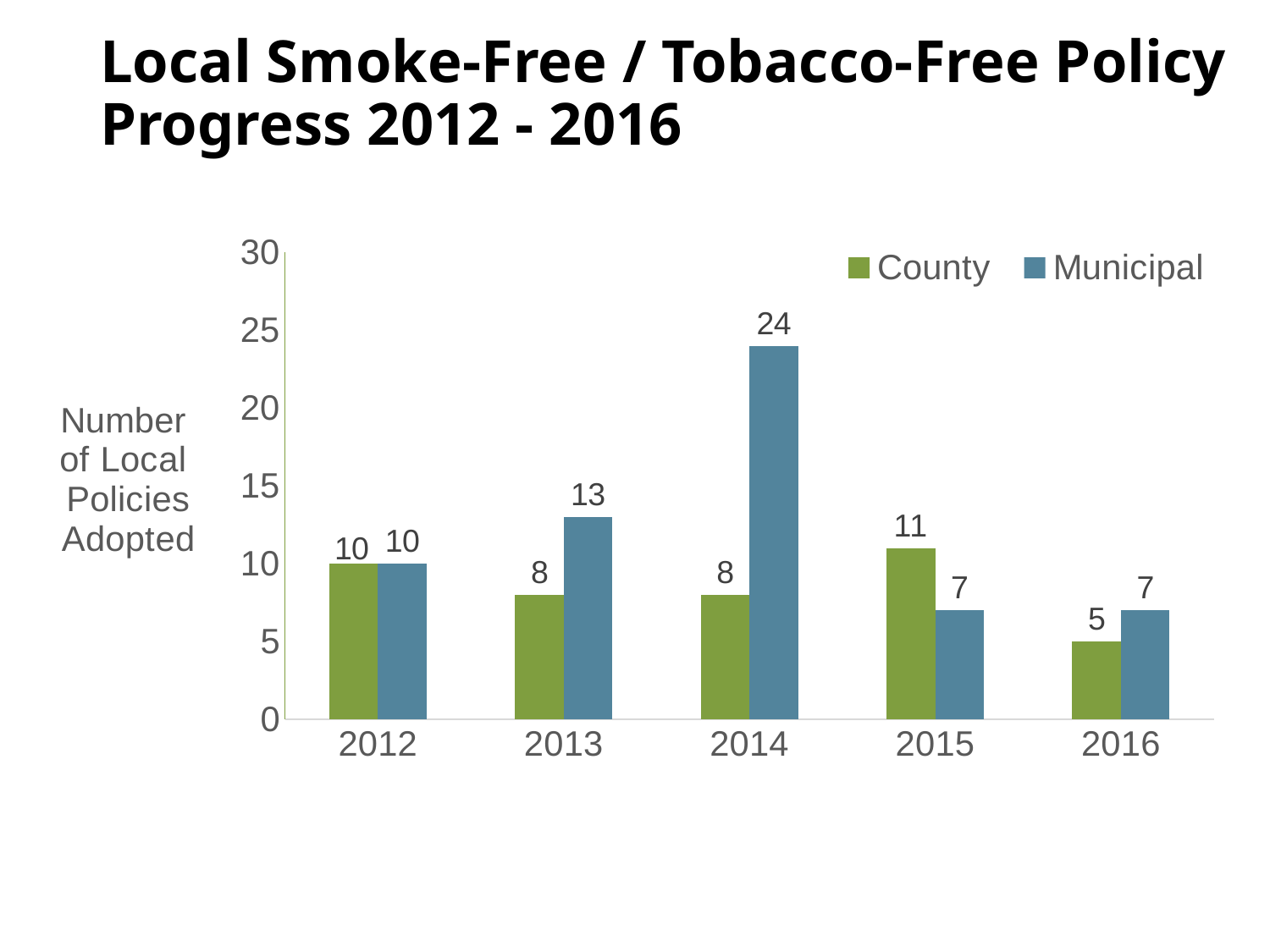
How many years are shown on the x axis? 5 What is the Municipal value for 2014? 24 What is the y-axis label of the chart? Number of Local Policies Adopted What kind of chart is shown on the slide? Bar chart Which year has the highest Municipal value? 2014 What is the County value for 2015? 11 What is the County value for 2016? 5 How many series does the legend list? 2 Which year has the lowest County value? 2016 Does the County value rise or fall from 2015 to 2016? Fall Which is larger in 2015, the County value or the Municipal value? County What is the difference between the Municipal and County values in 2014? 16